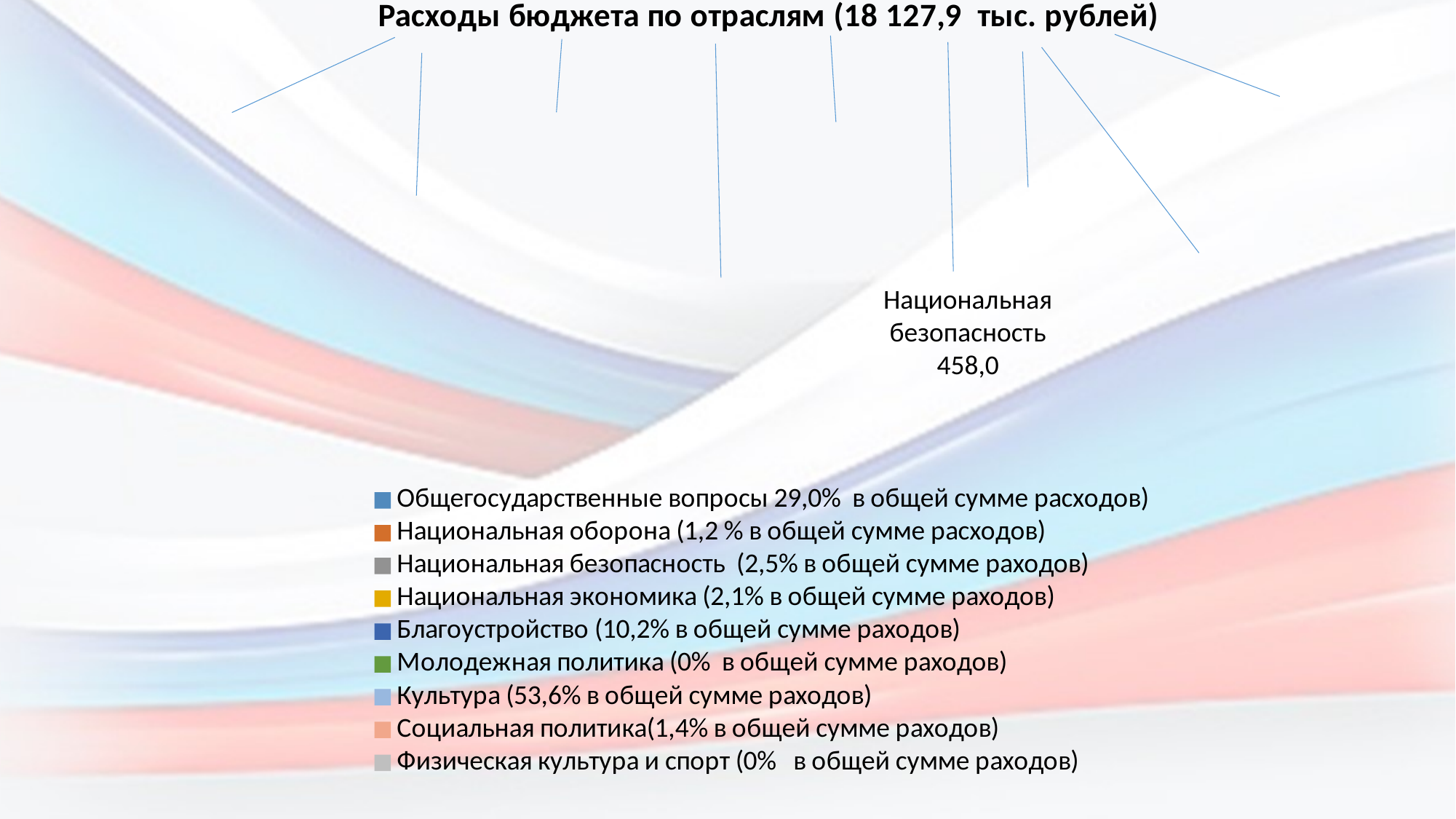
Which category has the largest share of total expenditure? Культура What is the title of the chart? Расходы бюджета по отраслям (18 127,9 тыс. рублей) What total amount of budget expenditure is stated in the chart title? 18 127,9 тыс. рублей According to the legend, what share of total expenditure does Благоустройство account for? 10,2% Which has a larger share of expenditure, Благоустройство or Общегосударственные вопросы? Общегосударственные вопросы According to the legend, what share of total expenditure does Культура account for? 53,6% According to the legend, what share of total expenditure does Общегосударственные вопросы account for? 29,0% Which has a larger share of expenditure, Национальная безопасность or Национальная экономика? Национальная безопасность What value is shown in the data label for Национальная безопасность? 458,0 How many categories does the legend list? 9 By how many percentage points does the share of Общегосударственные вопросы exceed that of Благоустройство? 18,8%